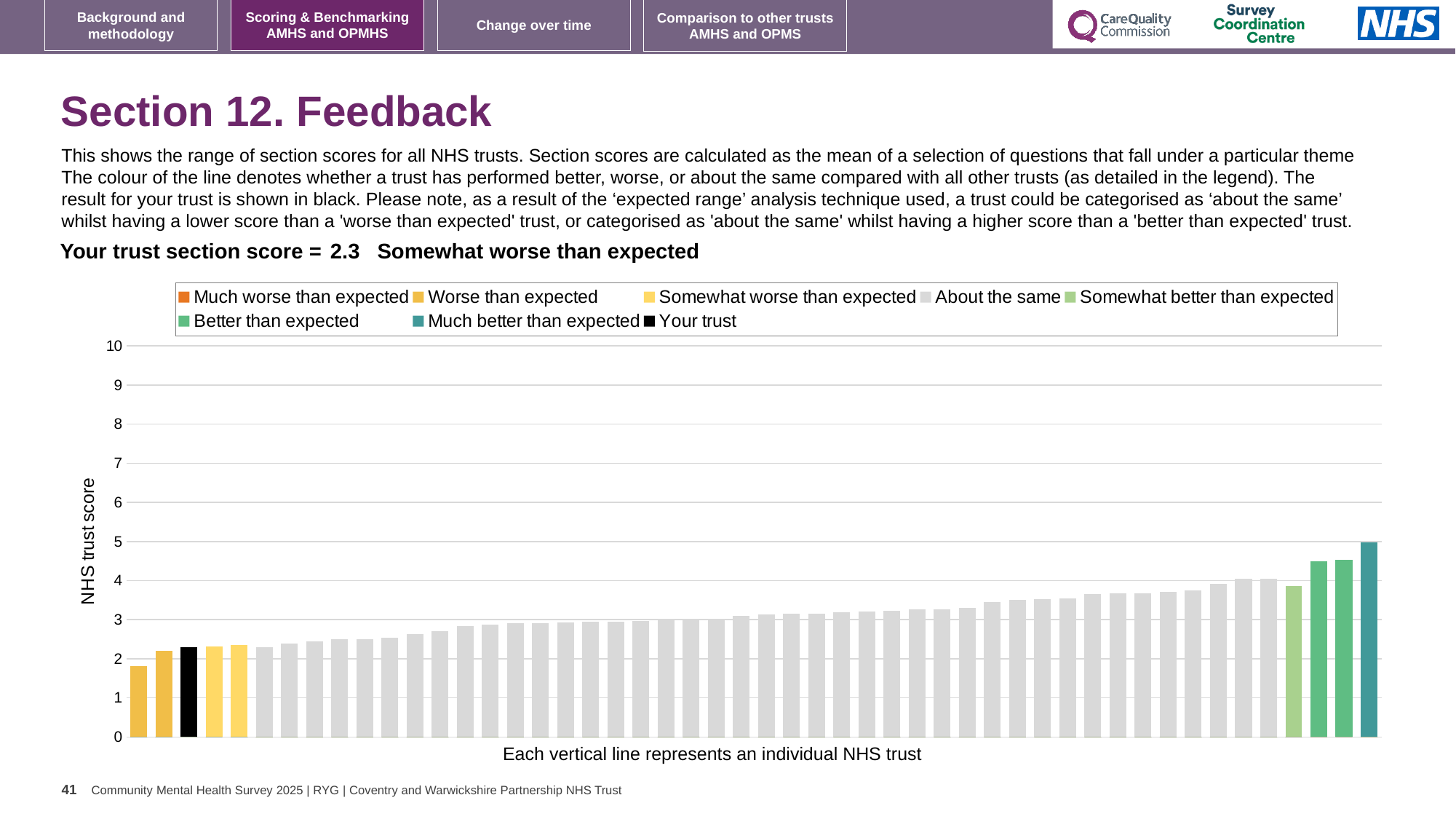
What kind of chart is shown on the slide? bar chart Is the value for your trust (the black bar) greater or less than 3? less How many bars are coloured as 'Better than expected'? 2 What is the section score for your trust? 2.3 Which performance category is your trust placed in for this section? Somewhat worse than expected Is the value of the tallest bar greater or less than 4? greater Which legend category does the shortest bar belong to? Worse than expected Which legend category does the tallest bar belong to? Much better than expected Is the value of the shortest bar greater or less than 3? less How many entries does the chart legend list? 8 Do the bar values rise or fall from left to right along the x axis? rise What is the label on the vertical axis of the chart? NHS trust score